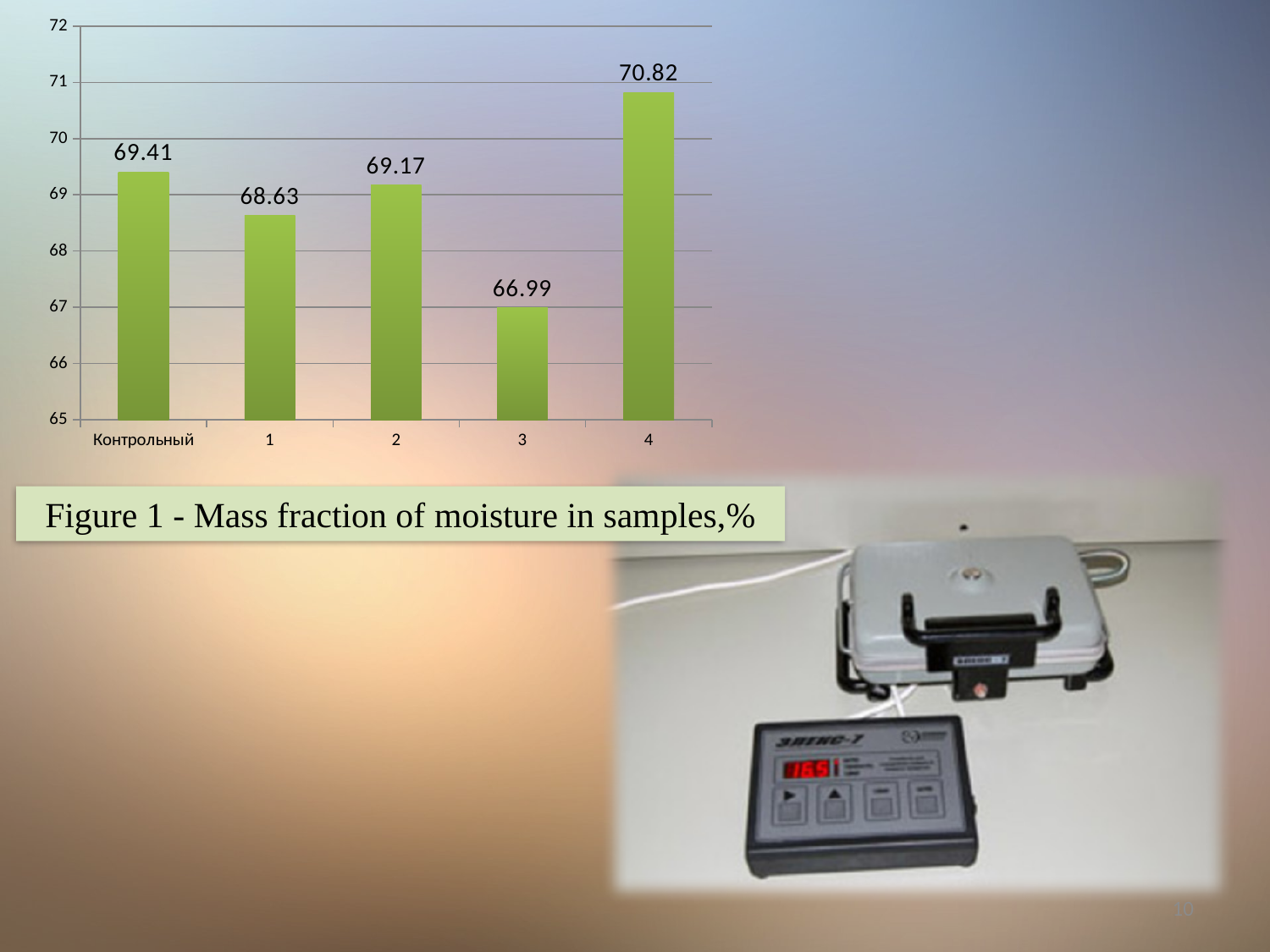
What is the value for the Контрольный sample? 69.41 What is the caption given for the chart? Figure 1 - Mass fraction of moisture in samples,% Is the value for sample 3 greater or less than 67? less Which sample has the highest value? 4 What is the difference between the values for sample 4 and sample 3? 3.83 What kind of chart is shown on the slide? bar chart What is the value for sample 3? 66.99 How many bars are shown in the chart? 5 Which is larger, the value for sample 1 or the value for sample 2? 2 What is the value for sample 4? 70.82 What is the difference between the values for Контрольный and sample 1? 0.78 Which sample has the lowest value? 3